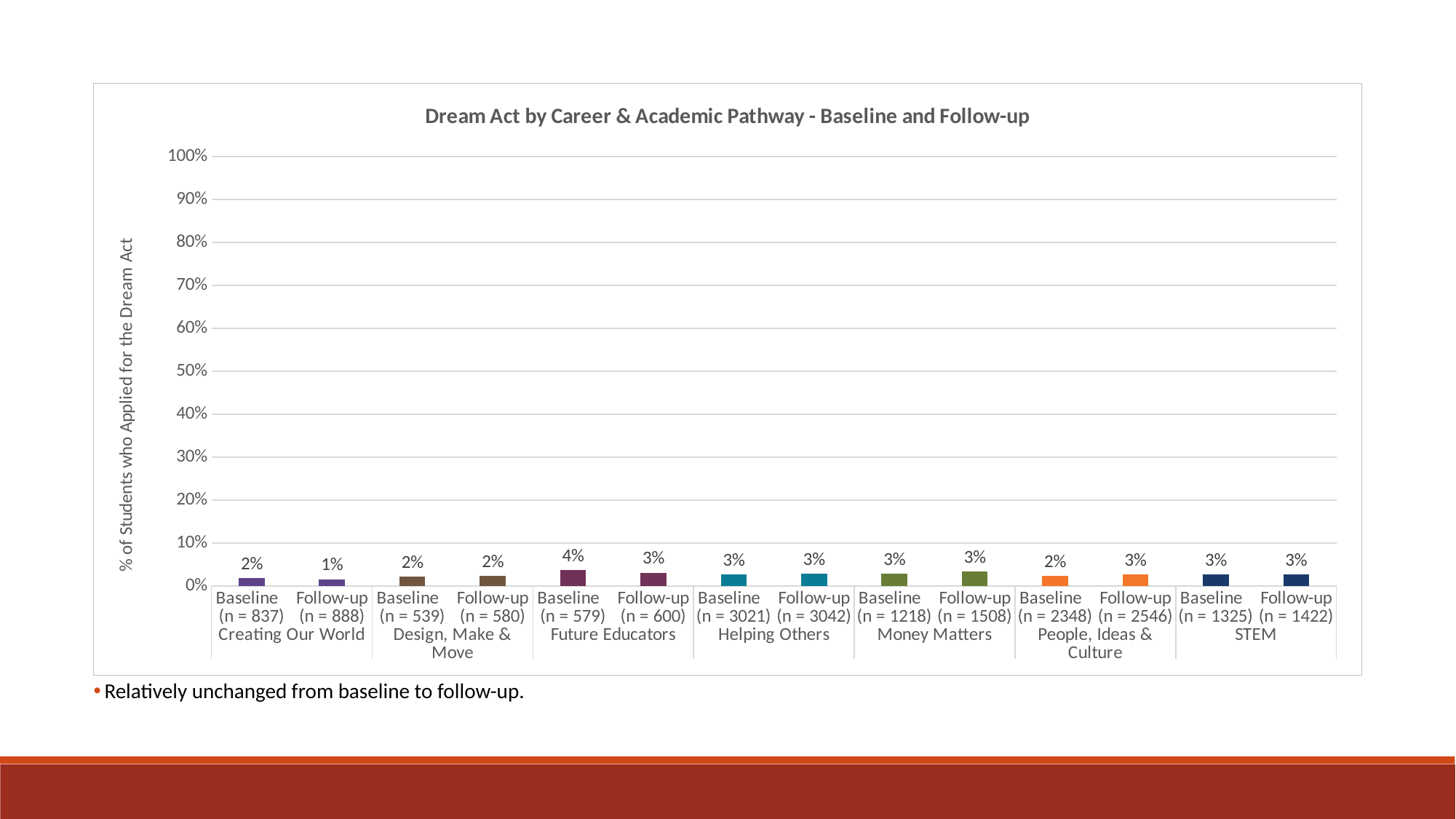
What is the Follow-up value for People, Ideas & Culture? 3% Which is larger for People, Ideas & Culture: the Baseline value or the Follow-up value? Follow-up Which bar has the lowest value on the chart? Creating Our World Follow-up What is the difference between the Baseline and Follow-up values for Future Educators? 1% What is the Baseline value for Future Educators? 4% What kind of chart is shown on the slide? Bar chart What is the Baseline value for STEM? 3% What is the Follow-up value for Creating Our World? 1% What is the title of the chart? Dream Act by Career & Academic Pathway - Baseline and Follow-up How many career and academic pathways are shown on the chart? 7 What is the label of the vertical axis? % of Students who Applied for the Dream Act Which bar has the highest value on the chart? Future Educators Baseline